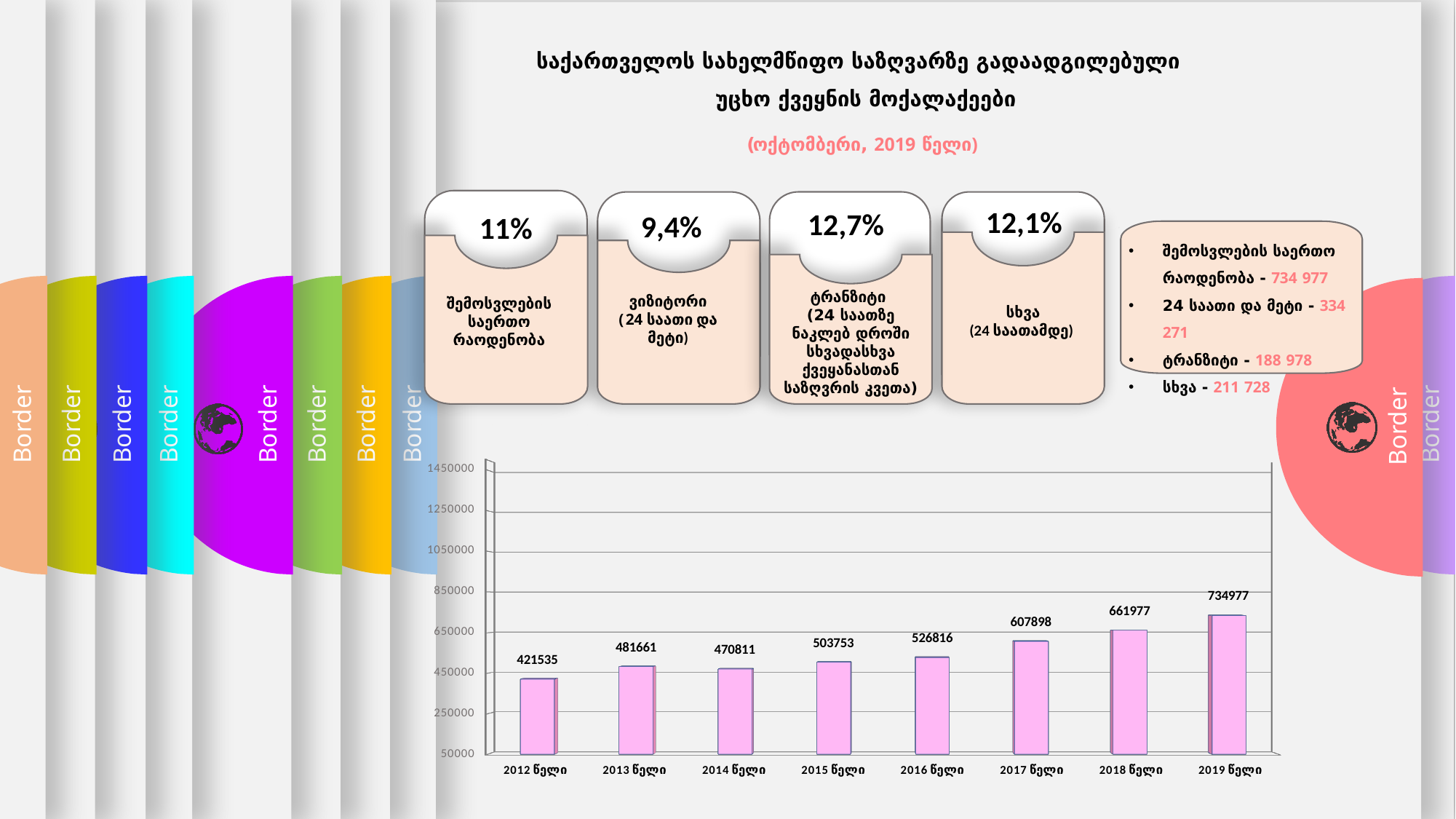
Which year has the highest value in the bar chart? 2019 წელი How many years (categories) are shown in the bar chart? 8 What is the difference between the values for 2019 and 2018 in the bar chart? 73000 What is the difference between the values for 2013 and 2014 in the bar chart? 10850 Is the value for 2017 in the bar chart greater or less than 650000? less What kind of chart is shown at the bottom of the slide? bar chart What is the value for 2018 (2018 წელი) in the bar chart? 661977 Which year has the lowest value in the bar chart? 2012 წელი What is the value for 2016 (2016 წელი) in the bar chart? 526816 What is the value for 2012 (2012 წელი) in the bar chart? 421535 Do the values in the bar chart generally rise or fall from 2012 to 2019? rise Which is larger in the bar chart, the value for 2013 or the value for 2014? 2013 წელი